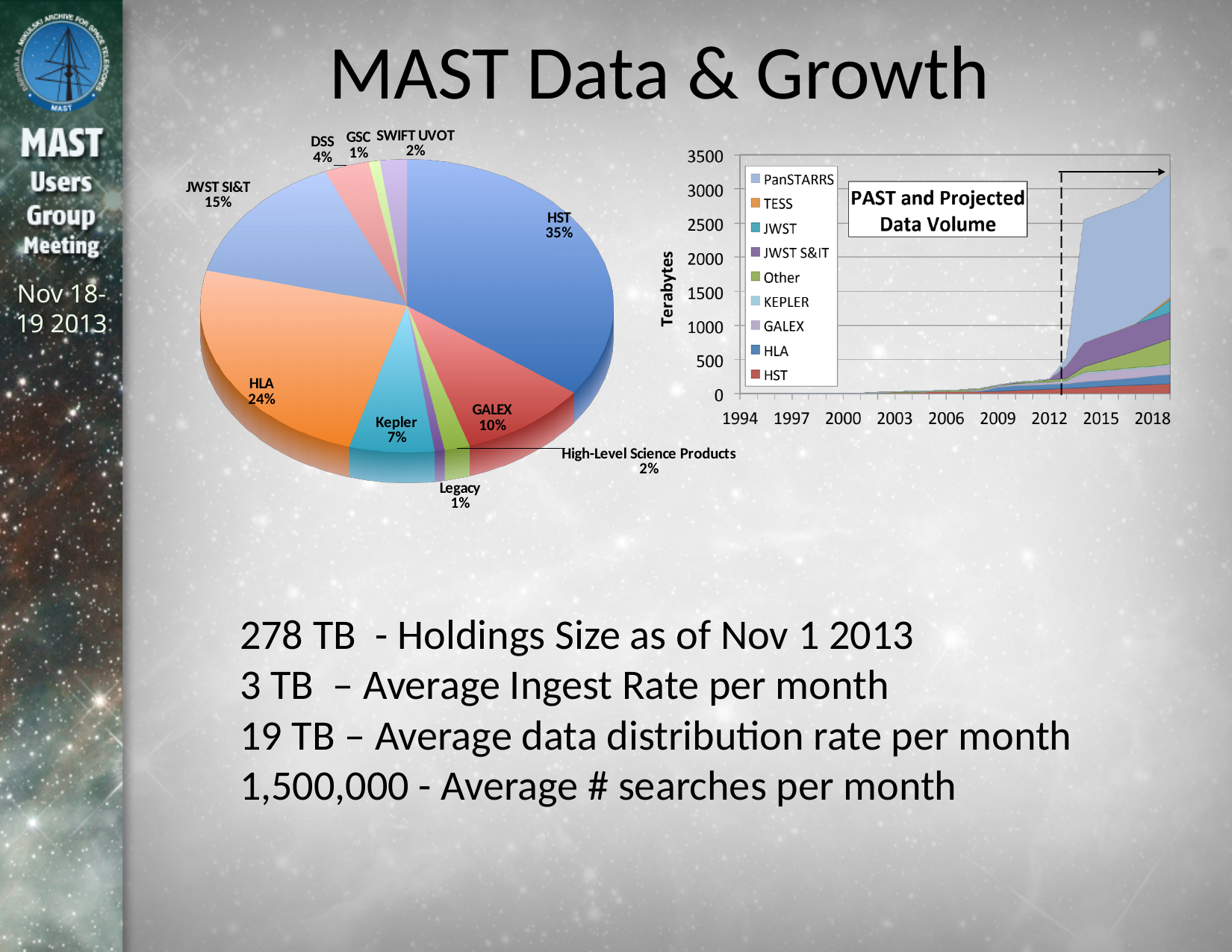
In the 'PAST and Projected Data Volume' chart, which series is listed first in the legend? PanSTARRS In the 'PAST and Projected Data Volume' chart, does the total data volume rise or fall from 1994 to 2018? Rise In the pie chart on the left, what share of the data does HST account for? 35% In the pie chart on the left, which category has the largest share? HST In the pie chart on the left, what is the difference in percentage points between HST and HLA? 11 How many series does the legend of the 'PAST and Projected Data Volume' chart list? 9 How many labelled slices does the pie chart on the left have? 10 What is the y-axis label of the 'PAST and Projected Data Volume' chart? Terabytes In the pie chart on the left, what percentage is shown for Kepler? 7% What kind of chart is the chart on the left of the slide? Pie chart In the pie chart on the left, what percentage is labelled for HLA? 24% In the pie chart on the left, which has a larger share, JWST SI&T or GALEX? JWST SI&T